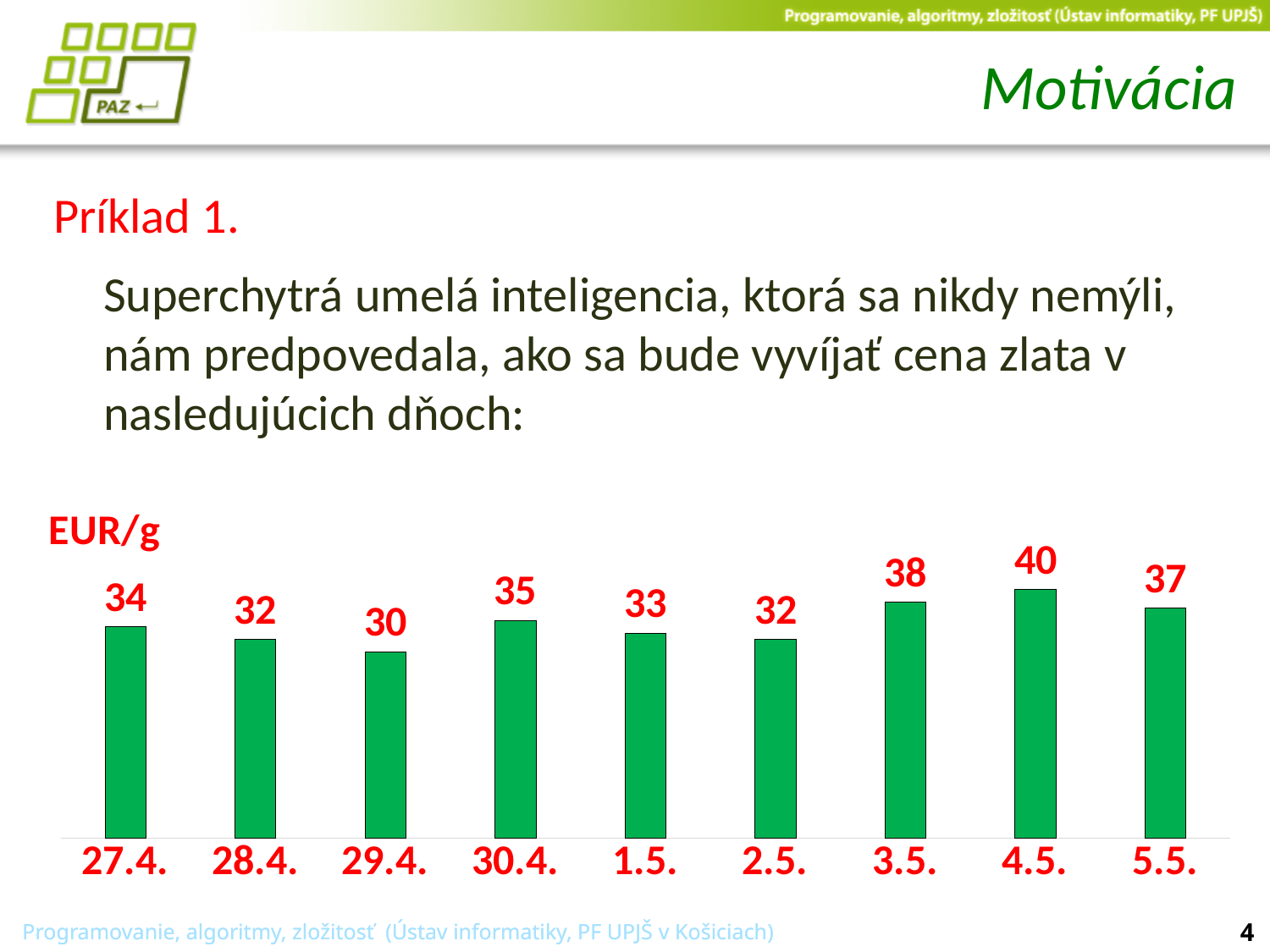
What is the difference between the values for 4.5. and 29.4.? 10 What is the value for 27.4.? 34 What kind of chart is shown on the slide? bar chart What unit label is shown above the chart? EUR/g How many dates are shown on the x axis? 9 What is the value for 1.5.? 33 Which is larger, the value for 30.4. or the value for 5.5.? 5.5. Which date has the lowest value? 29.4. What is the value for 4.5.? 40 Do the values rise or fall from 29.4. to 30.4.? rise What is the difference between the values for 3.5. and 2.5.? 6 Which date has the highest value? 4.5.